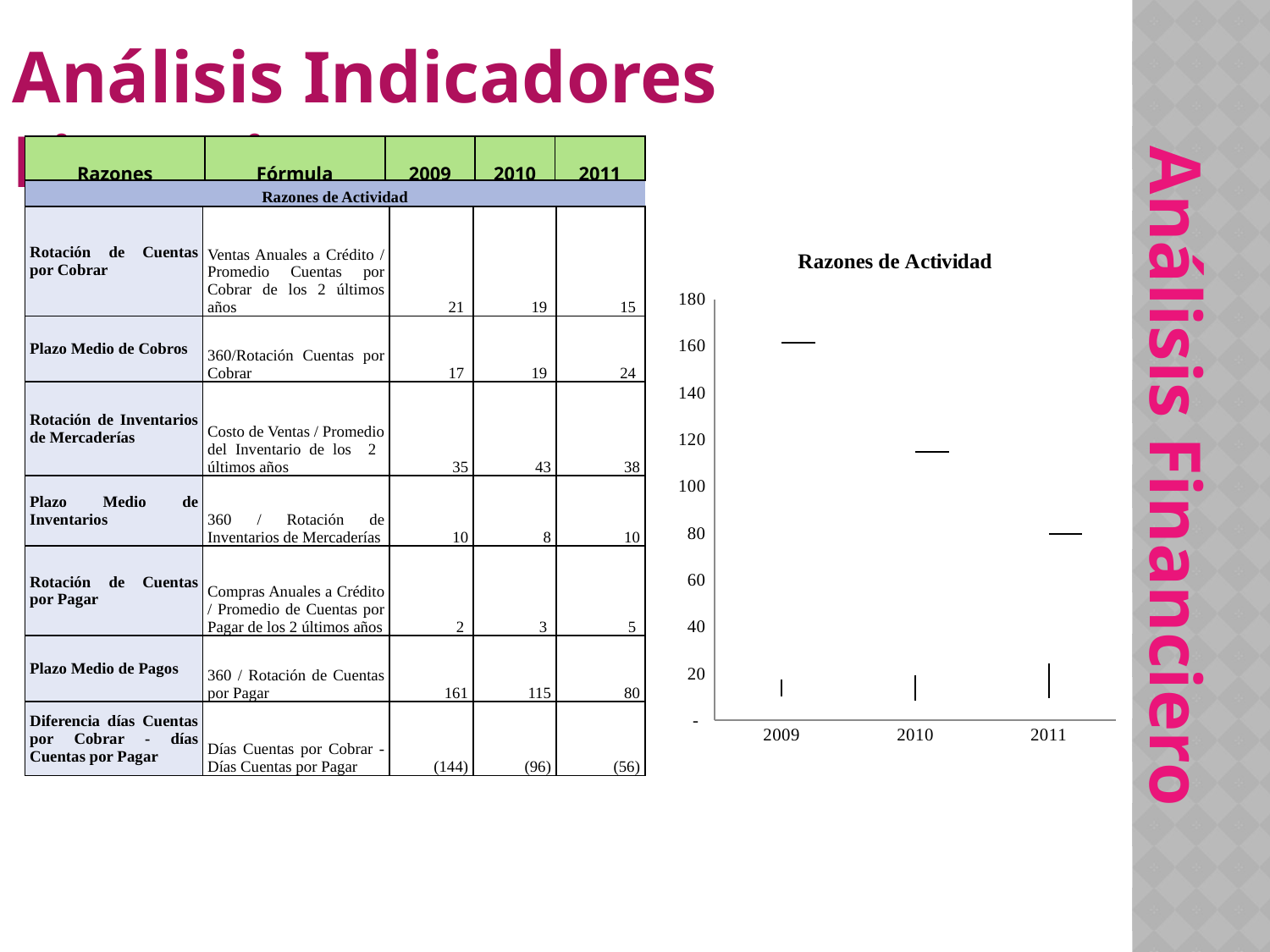
How many years are shown on the x axis of the chart? 3 Which year has the lowest horizontal marker in the chart? 2011 Is the horizontal marker for 2010 greater or less than 100? greater Is the horizontal marker for 2011 greater or less than 60? greater Is the horizontal marker for 2011 greater or less than 100? less What is the highest value shown on the y axis of the chart? 180 Which year has a higher horizontal marker, 2009 or 2010? 2009 What is the title of the chart on the slide? Razones de Actividad Which year has the highest horizontal marker in the chart? 2009 Do the horizontal markers rise or fall from 2009 to 2011? fall